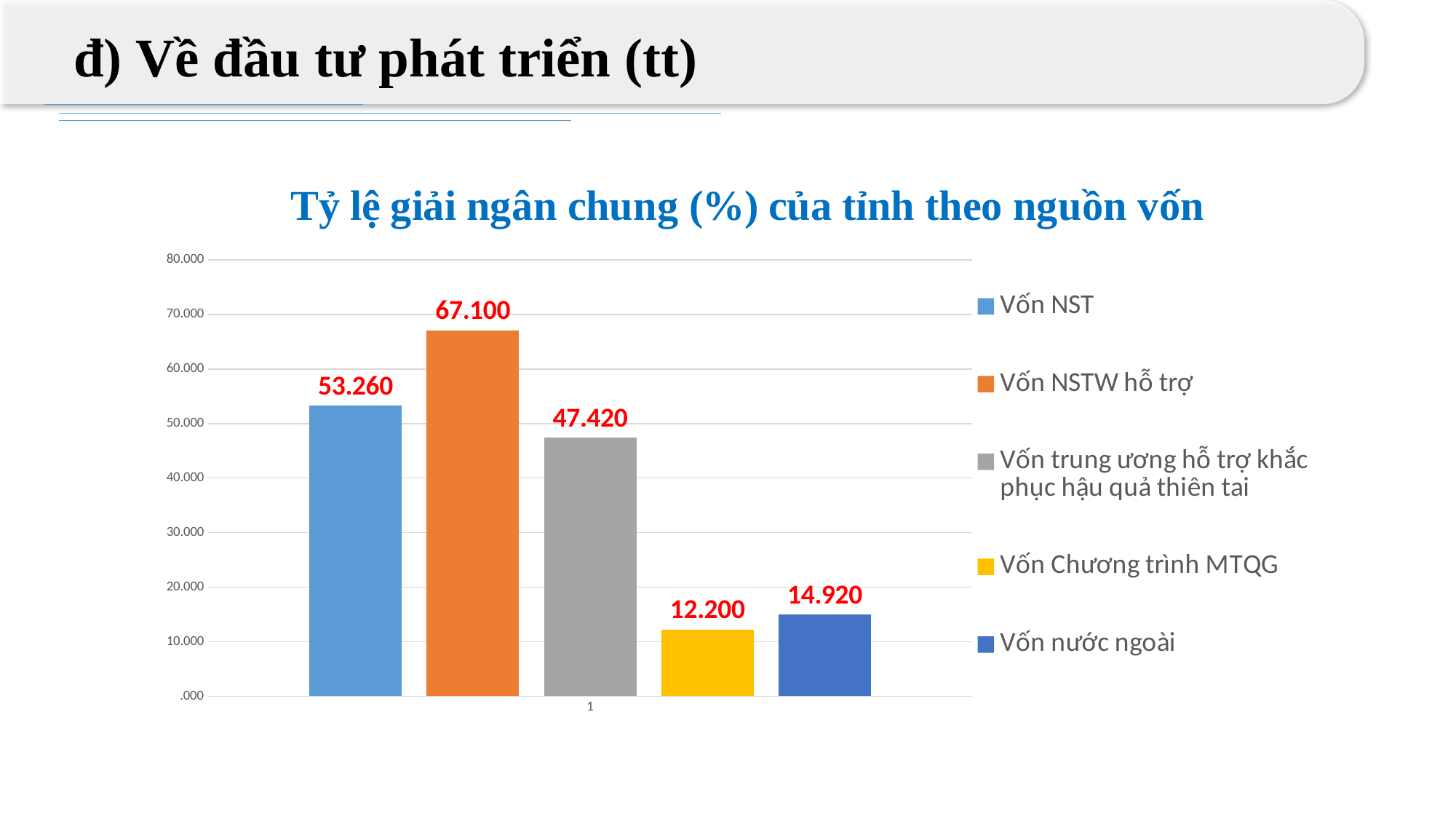
How many series does the legend list? 5 What kind of chart is shown on the slide? Bar chart What is the difference between the values for Vốn nước ngoài and Vốn Chương trình MTQG? 2.720 What is the value for Vốn nước ngoài? 14.920 What is the value for Vốn Chương trình MTQG? 12.200 What is the difference between the values for Vốn NSTW hỗ trợ and Vốn NST? 13.840 What is the value for Vốn NSTW hỗ trợ? 67.100 What is the title of the chart? Tỷ lệ giải ngân chung (%) của tỉnh theo nguồn vốn Which funding source has the lowest value? Vốn Chương trình MTQG Which funding source has the highest value? Vốn NSTW hỗ trợ What is the value for Vốn NST? 53.260 Which is larger, the value for Vốn NST or the value for Vốn trung ương hỗ trợ khắc phục hậu quả thiên tai? Vốn NST